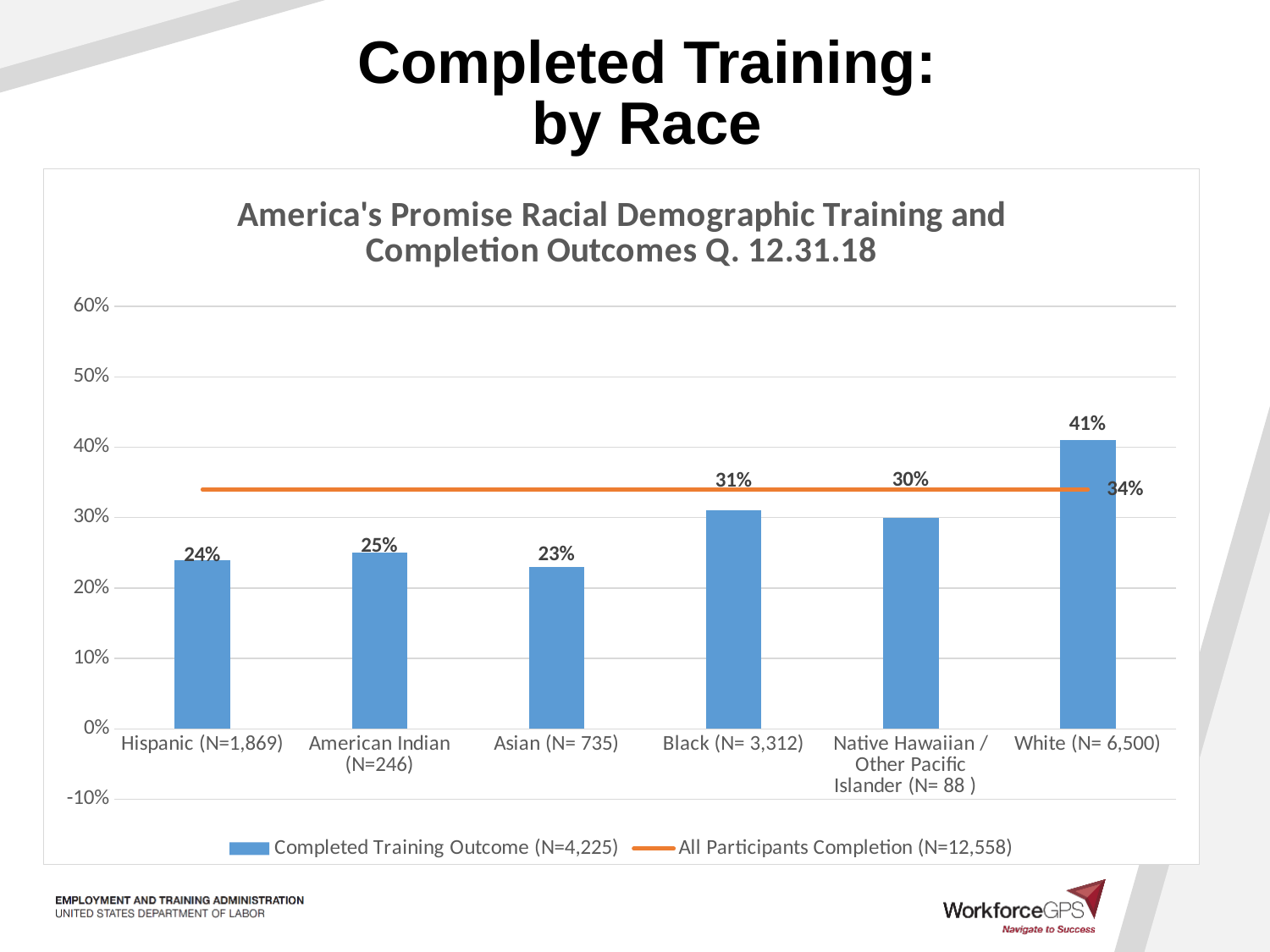
What is the title of the chart? America's Promise Racial Demographic Training and Completion Outcomes Q. 12.31.18 How many series does the legend list? 2 Which racial category has the highest Completed Training Outcome? White (N= 6,500) Is the Completed Training Outcome for White (N= 6,500) greater or less than 40%? greater What is the difference between the Completed Training Outcome for White (N= 6,500) and Asian (N= 735)? 18% Which racial category has the lowest Completed Training Outcome? Asian (N= 735) What is the Completed Training Outcome value for Black (N= 3,312)? 31% Which has a higher Completed Training Outcome, American Indian (N=246) or Black (N= 3,312)? Black (N= 3,312) What is the Completed Training Outcome value for Hispanic (N=1,869)? 24% What value is labelled on the All Participants Completion line? 34% What is the Completed Training Outcome value for Native Hawaiian / Other Pacific Islander (N= 88 )? 30% How many racial categories are shown on the x axis? 6